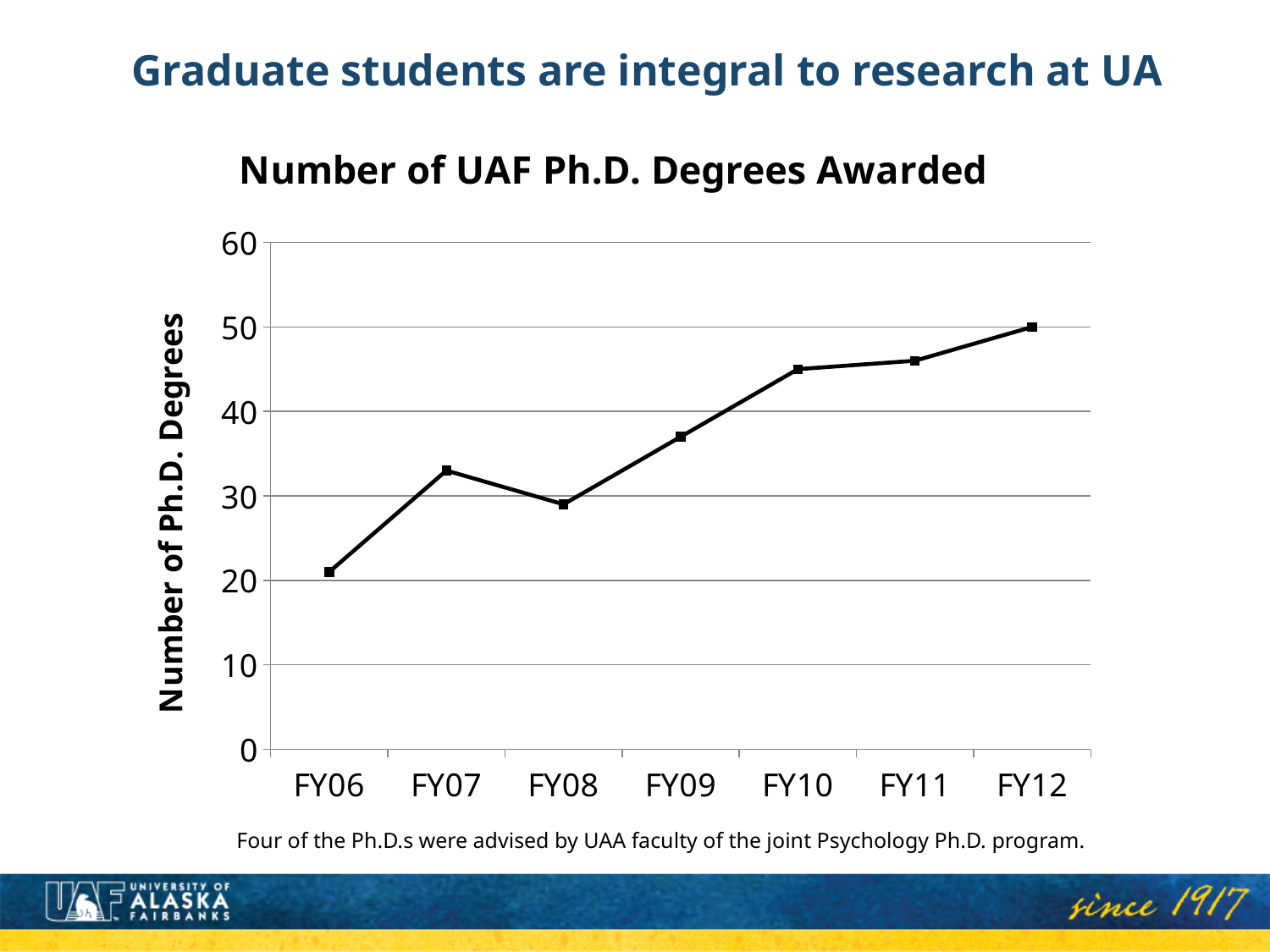
What is the title of the chart? Number of UAF Ph.D. Degrees Awarded Which year had more Ph.D. degrees awarded, FY07 or FY08? FY07 Is the value for FY10 greater or less than 40? greater Which fiscal year has the highest number of Ph.D. degrees awarded? FY12 Is the value for FY06 greater or less than 30? less Which fiscal year has the lowest number of Ph.D. degrees awarded? FY06 How many Ph.D. degrees were awarded in FY12? 50 Is the value for FY07 greater or less than 30? greater What kind of chart is shown on the slide? line chart Overall, do the number of Ph.D. degrees awarded rise or fall from FY06 to FY12? rise What is the label on the vertical axis of the chart? Number of Ph.D. Degrees How many fiscal years are plotted on the chart? 7